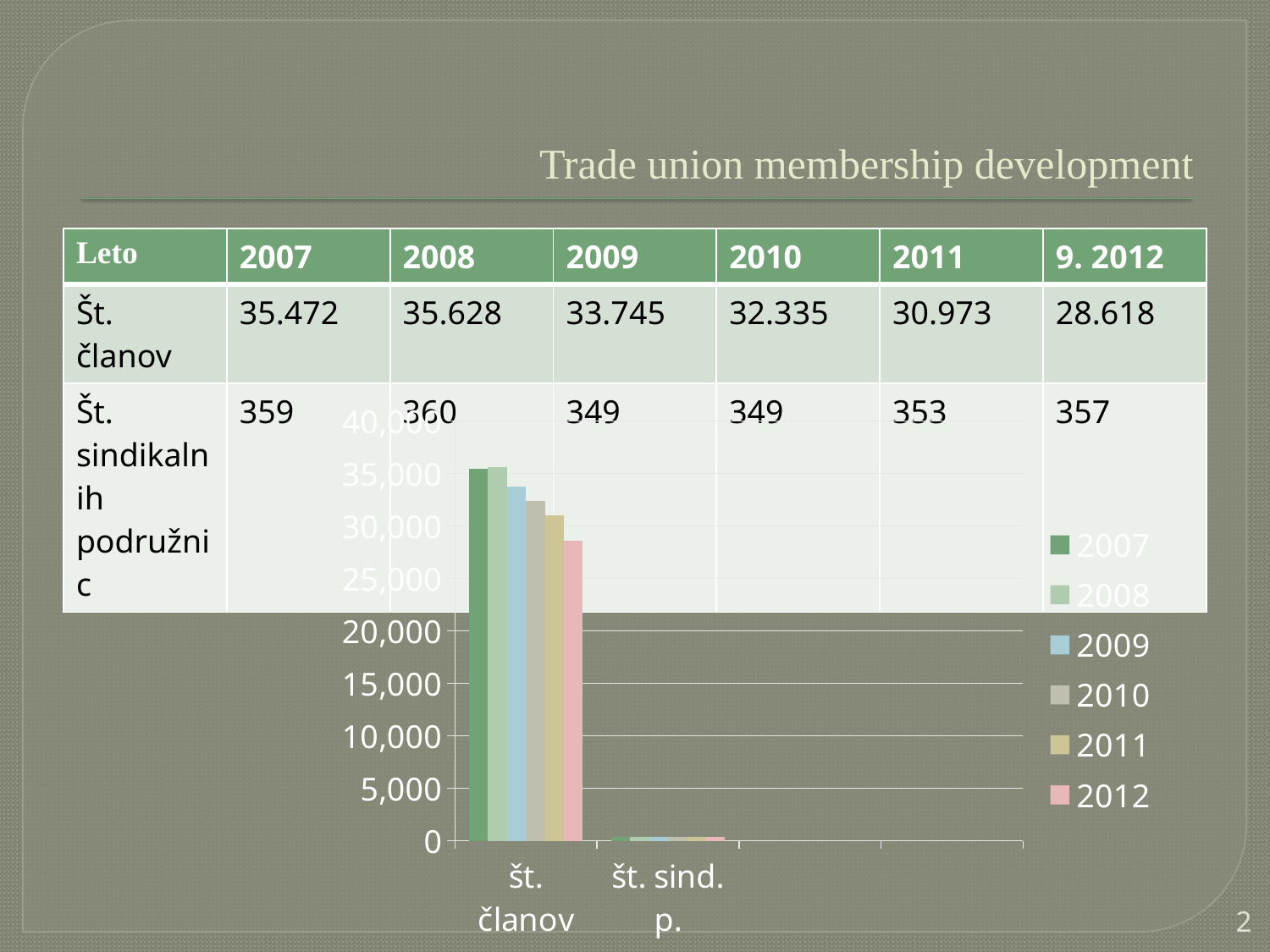
Which year is listed first in the chart legend? 2007 Which is larger in the 'št. članov' category, the value for 2009 or the value for 2012? 2009 Is the value for 2007 in the 'št. sind. p.' category greater or less than 5,000? less Is the value for 2012 in the 'št. članov' category greater or less than 30,000? less Is the value for 2010 in the 'št. članov' category greater or less than 35,000? less Which category has the taller bars, 'št. članov' or 'št. sind. p.'? št. članov What kind of chart is shown on the slide? bar chart Which year has the lowest value in the 'št. članov' category? 2012 How many categories are shown on the x axis of the chart? 2 From 2008 to 2012, do the bars for 'št. članov' rise or fall? fall How many series does the chart legend list? 6